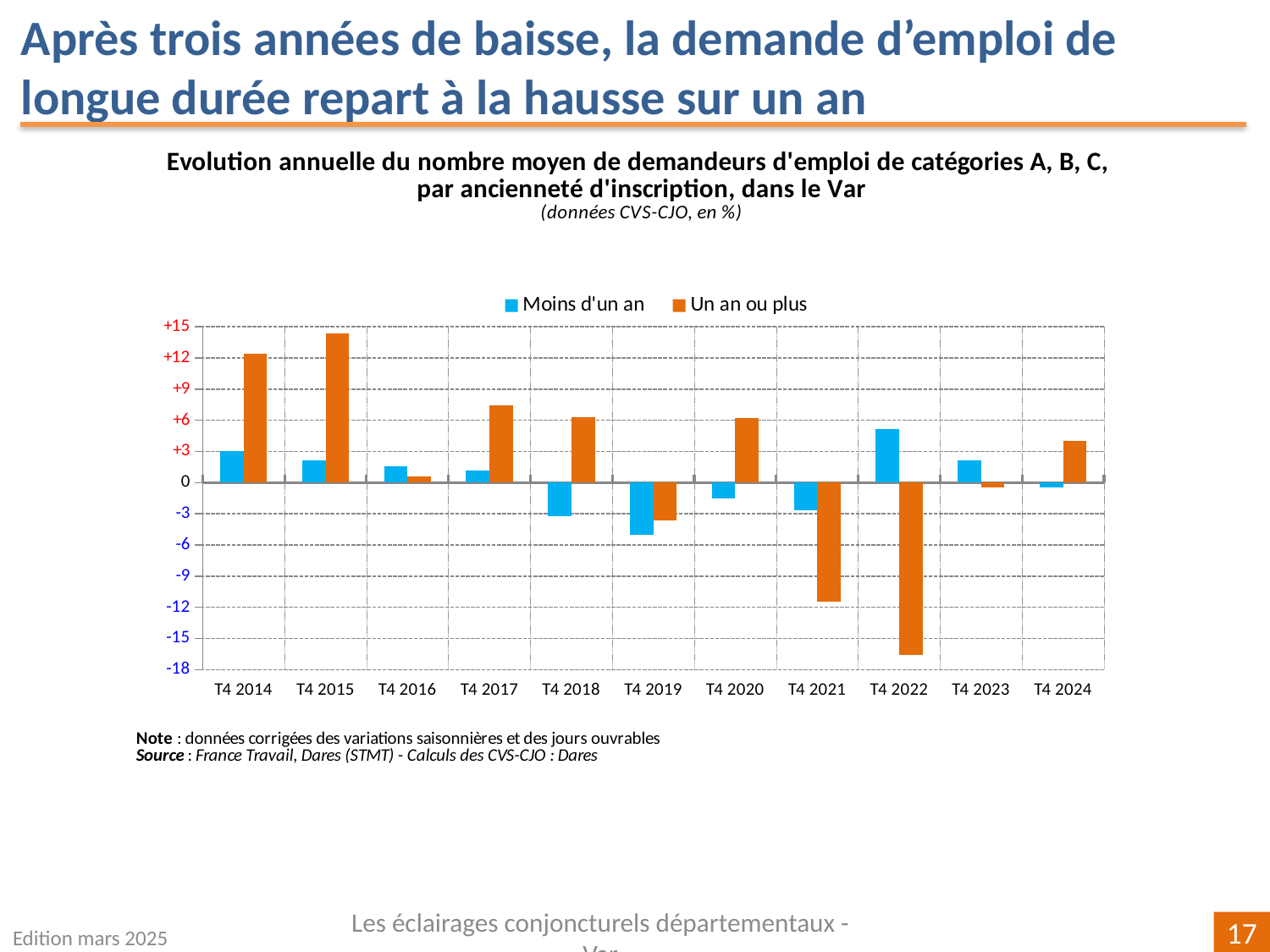
For the series 'Un an ou plus', which is larger: the value in T4 2014 or in T4 2015? T4 2015 For the series 'Un an ou plus', which quarter has the lowest value? T4 2022 How many quarters (categories) are shown on the x axis? 11 For the series 'Un an ou plus', which quarter has the highest value? T4 2015 How many series does the legend list? 2 Is the value for 'Un an ou plus' in T4 2014 greater or less than +9? greater For the series 'Moins d'un an', which quarter has the lowest value? T4 2019 What are the two series named in the legend? Moins d'un an; Un an ou plus Is the value for 'Moins d'un an' in T4 2019 greater or less than -3? less For the series 'Moins d'un an', which quarter has the highest value? T4 2022 Is the value for 'Un an ou plus' in T4 2022 greater or less than -15? less What kind of chart is shown on the slide? bar chart